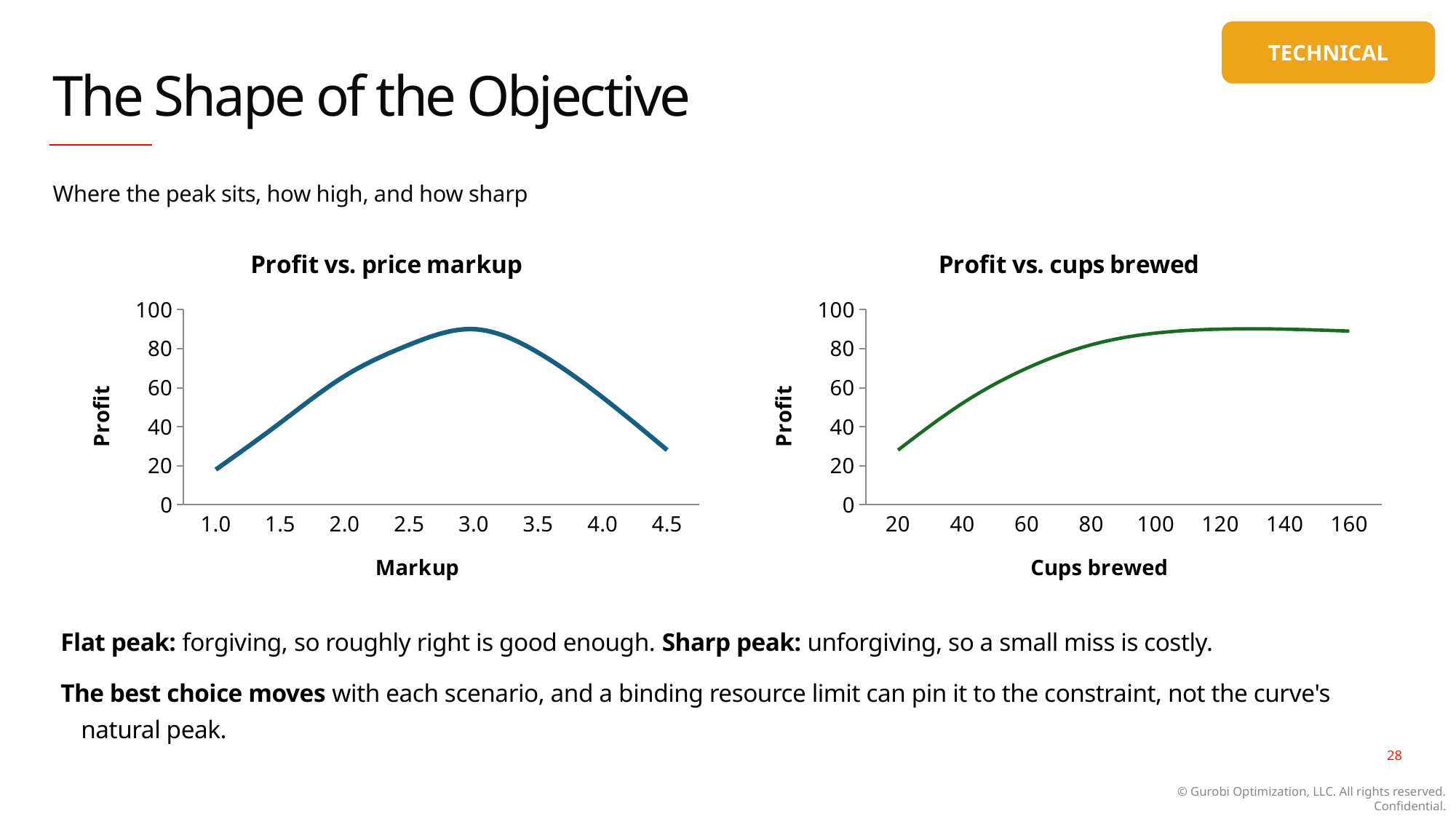
What kind of chart is the 'Profit vs. price markup' chart? line chart What kind of chart is the 'Profit vs. cups brewed' chart? line chart What is the x-axis label of the 'Profit vs. cups brewed' chart? Cups brewed In the 'Profit vs. price markup' chart, is the profit at a markup of 4.5 greater or less than 40? less In the 'Profit vs. price markup' chart, how does profit change as markup increases from 1.0 to 4.5? rises to a peak then falls In the 'Profit vs. cups brewed' chart, is the profit at 160 cups brewed greater or less than 80? greater In the 'Profit vs. cups brewed' chart, which has the higher profit: 20 cups brewed or 100 cups brewed? 100 cups brewed In the 'Profit vs. cups brewed' chart, is the profit at 20 cups brewed greater or less than 40? less In the 'Profit vs. price markup' chart, at which markup value does profit reach its highest point? 3.0 What is the y-axis label of the 'Profit vs. price markup' chart? Profit